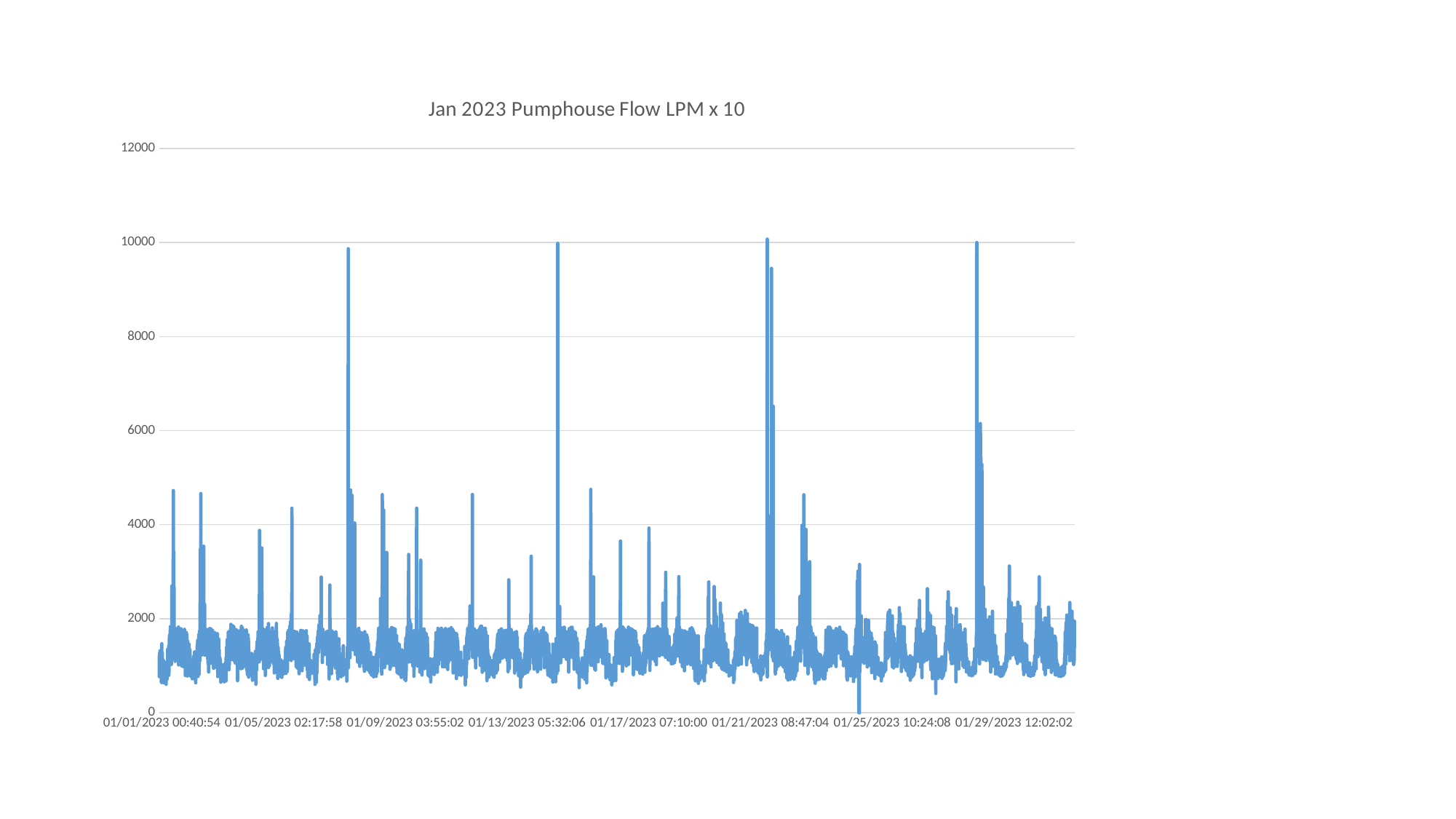
Is the highest value plotted on the chart greater or less than 12000? less Is the highest value plotted on the chart greater or less than 8000? greater What is the highest value labelled on the y axis? 12000 What kind of chart is shown on the slide? line chart How many date labels are shown along the x axis? 8 What is the title of the chart? Jan 2023 Pumphouse Flow LPM x 10 Is the lowest value plotted on the chart greater or less than 2000? less How many series are plotted on the chart? 1